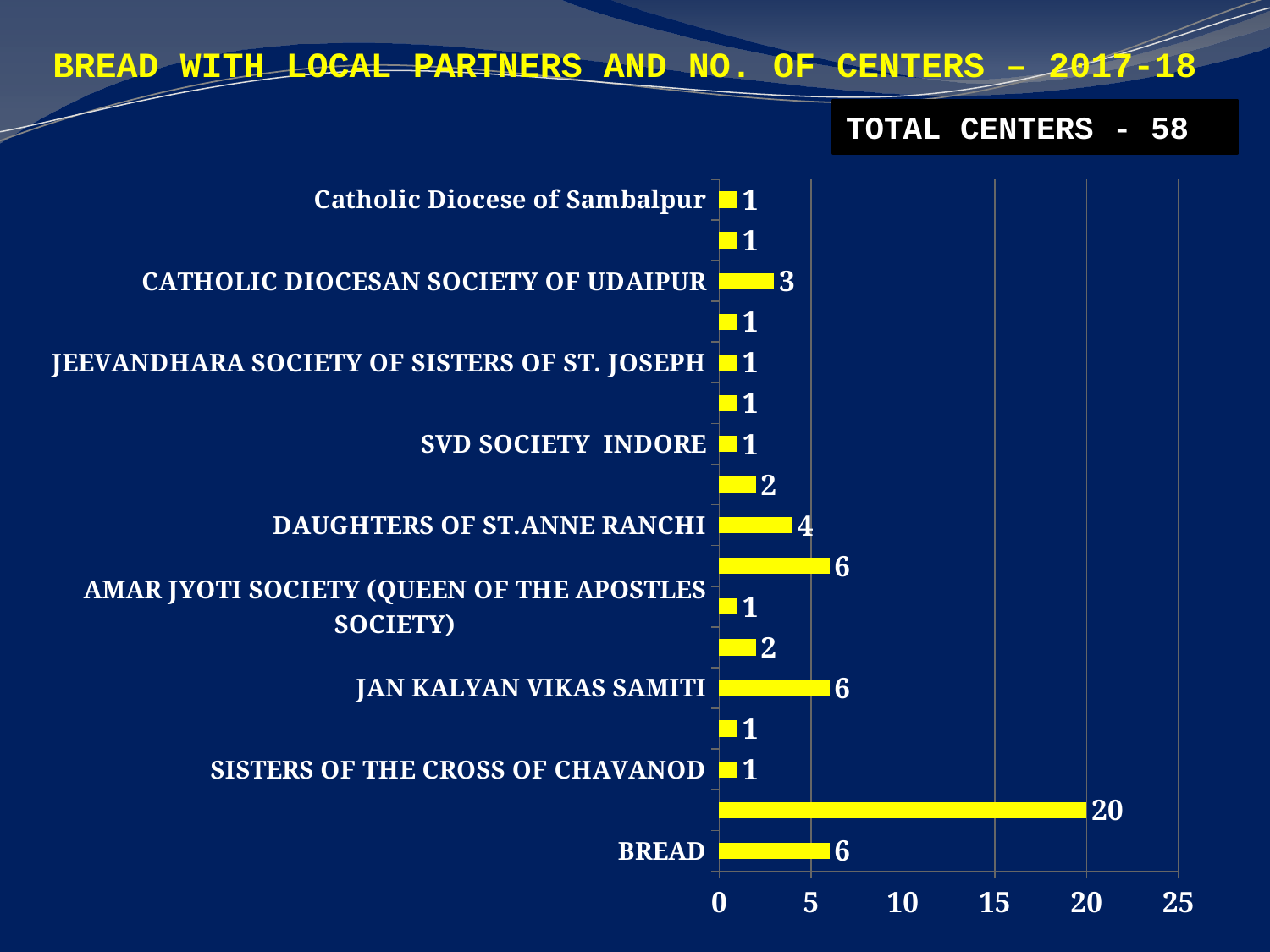
What total number of centers is stated on the slide? 58 What is the value for DAUGHTERS OF ST.ANNE RANCHI? 4 How many bars are plotted in the chart? 17 Which has a larger value, CATHOLIC DIOCESAN SOCIETY OF UDAIPUR or SVD SOCIETY INDORE? CATHOLIC DIOCESAN SOCIETY OF UDAIPUR What is the difference between the values for JAN KALYAN VIKAS SAMITI and DAUGHTERS OF ST.ANNE RANCHI? 2 What is the value for SISTERS OF THE CROSS OF CHAVANOD? 1 What kind of chart is shown on the slide? bar chart What is the value for BREAD? 6 What is the value for CATHOLIC DIOCESAN SOCIETY OF UDAIPUR? 3 What is the value for JAN KALYAN VIKAS SAMITI? 6 Is the value of the longest bar greater or less than 15? greater What is the largest value plotted in the chart? 20